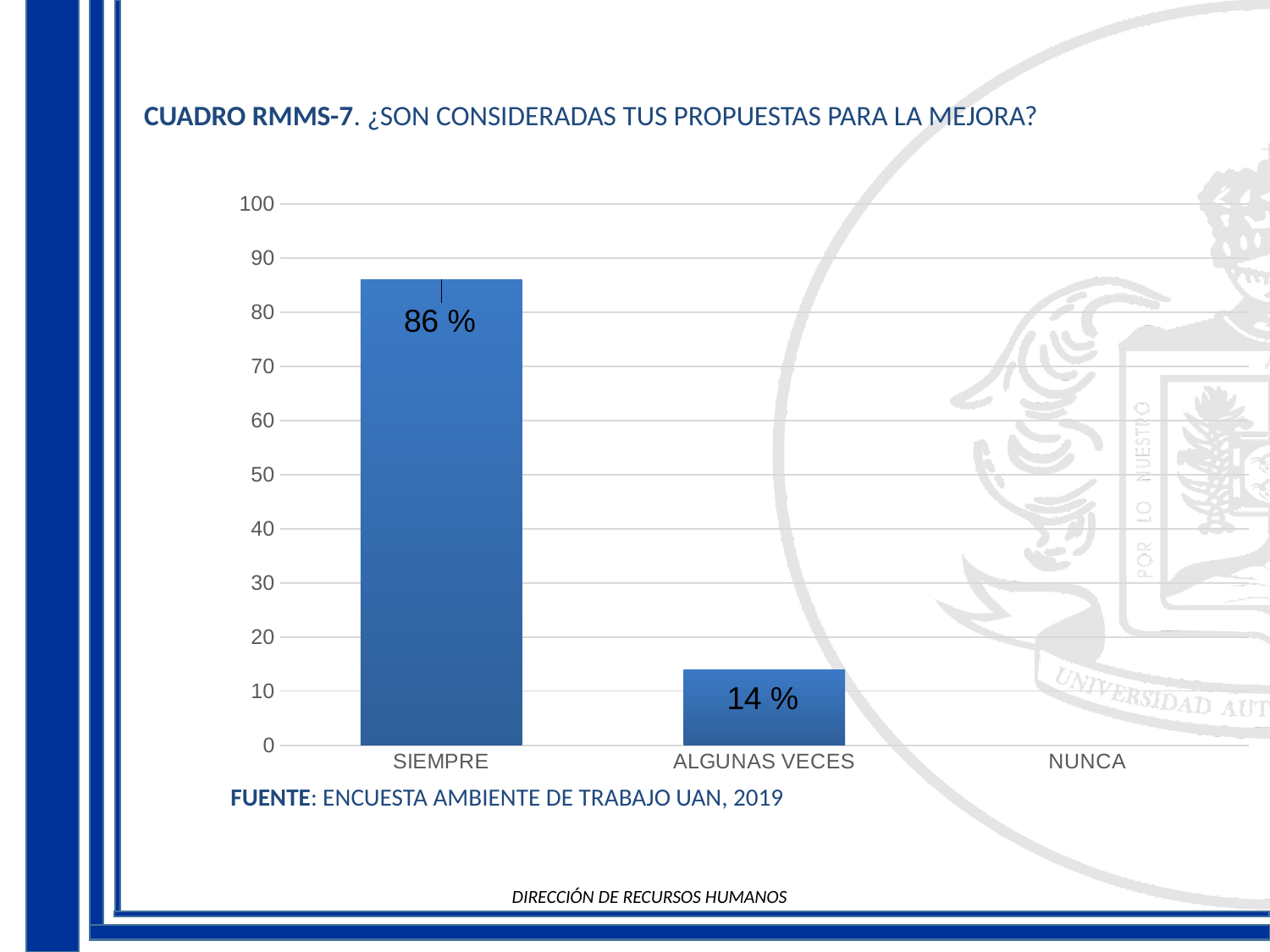
Which category has the highest value? SIEMPRE Is the value for ALGUNAS VECES greater or less than 20? less Do the values rise or fall from SIEMPRE to ALGUNAS VECES? fall Is the value for SIEMPRE greater or less than 80? greater What is the title of the chart? CUADRO RMMS-7. ¿SON CONSIDERADAS TUS PROPUESTAS PARA LA MEJORA? What is the source cited below the chart? ENCUESTA AMBIENTE DE TRABAJO UAN, 2019 What kind of chart is shown on the slide? bar chart Which is larger, the value for SIEMPRE or the value for ALGUNAS VECES? SIEMPRE What is the value for ALGUNAS VECES? 14 % What is the value for SIEMPRE? 86 % What is the difference between the values for SIEMPRE and ALGUNAS VECES? 72 % How many categories are shown on the x axis? 3